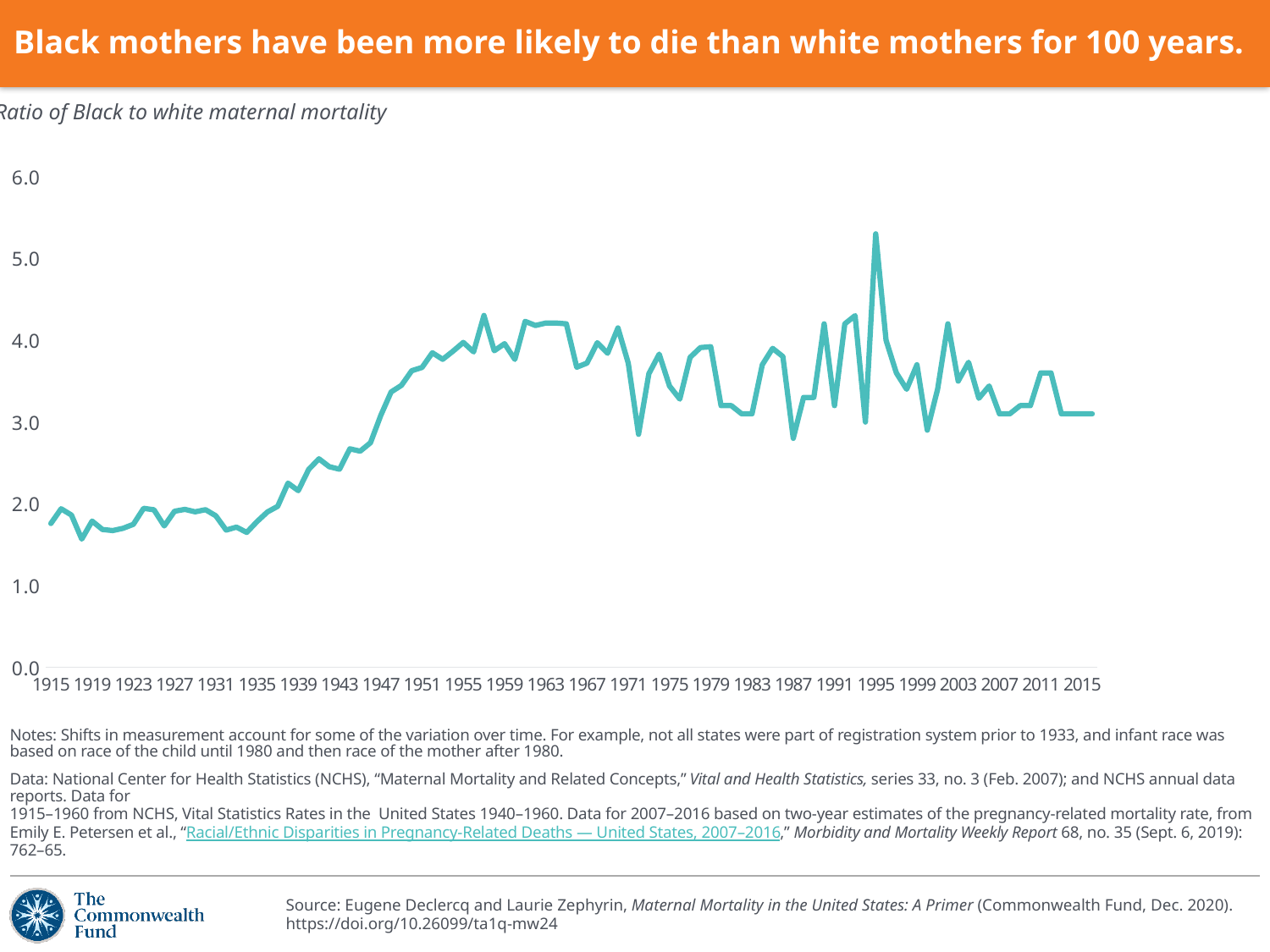
What does the chart plot, according to the label above it? Ratio of Black to white maternal mortality Does the ratio rise or fall between 1935 and 1955? rise Is the ratio in 1915 greater or less than 2.0? less What is the title of the slide? Black mothers have been more likely to die than white mothers for 100 years. Which year has the larger ratio, 1923 or 1963? 1963 Is the ratio in 1939 greater or less than 2.0? greater What kind of chart is shown on the slide? line chart In which year does the ratio of Black to white maternal mortality reach its highest point? 1995 Is the ratio in 1943 greater or less than 3.0? less How many year labels are shown on the x axis? 26